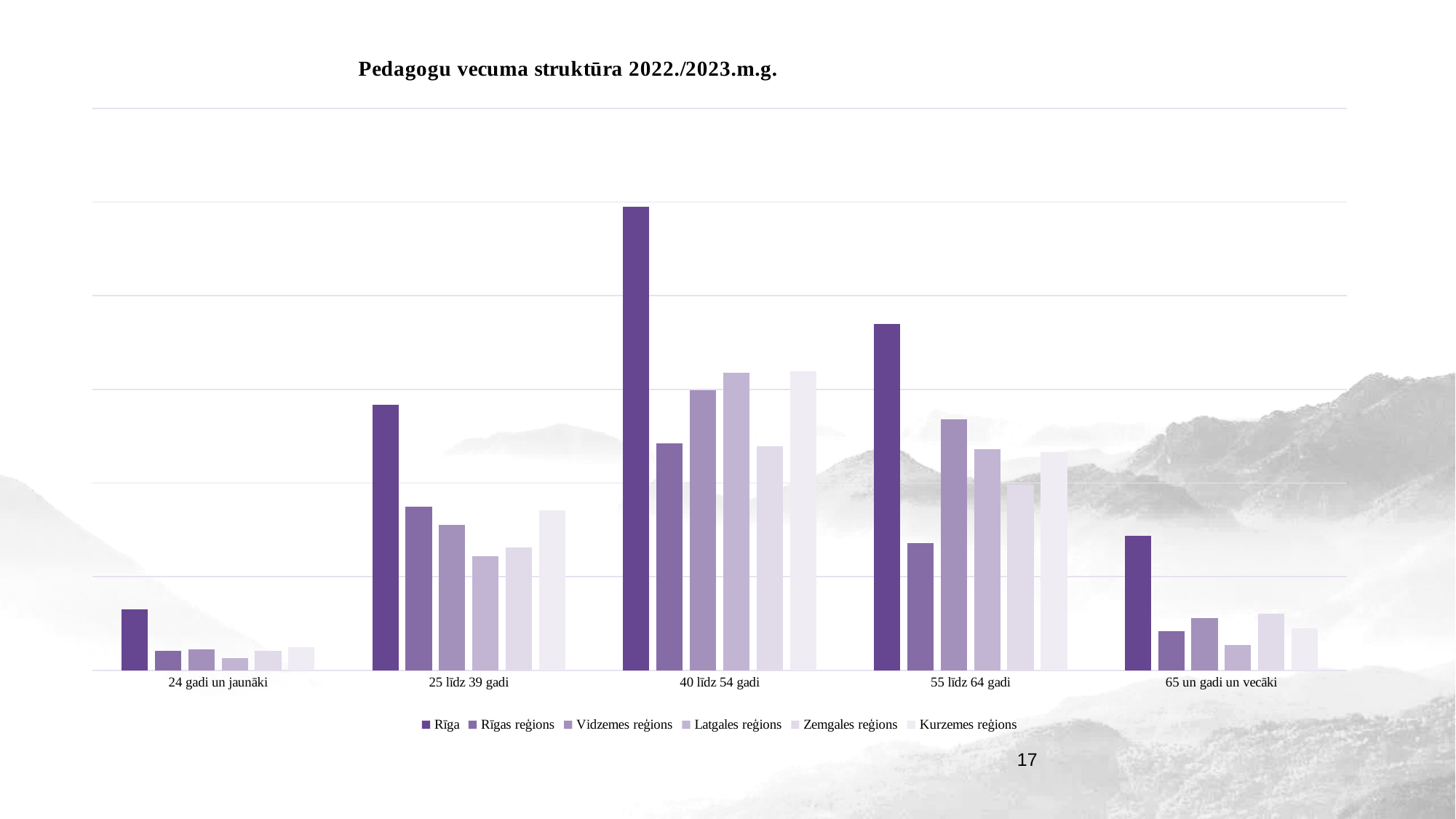
In the 65 un gadi un vecāki category, which series has the lowest value? Latgales reģions For the Rīga series, which age category has the highest value? 40 līdz 54 gadi What is the title of the chart? Pedagogu vecuma struktūra 2022./2023.m.g. How many series does the chart's legend list? 6 What kind of chart is shown on the slide? bar chart How many age categories are shown on the x axis of the chart? 5 In the 24 gadi un jaunāki category, which series has the lowest value? Latgales reģions Which series is listed first in the chart's legend? Rīga Does the Rīga series rise or fall from 40 līdz 54 gadi to 65 un gadi un vecāki? fall For the Rīga series, which age category has the lowest value? 24 gadi un jaunāki In the 25 līdz 39 gadi category, which is larger: Rīga or Rīgas reģions? Rīga In the 55 līdz 64 gadi category, which is larger: Vidzemes reģions or Rīgas reģions? Vidzemes reģions